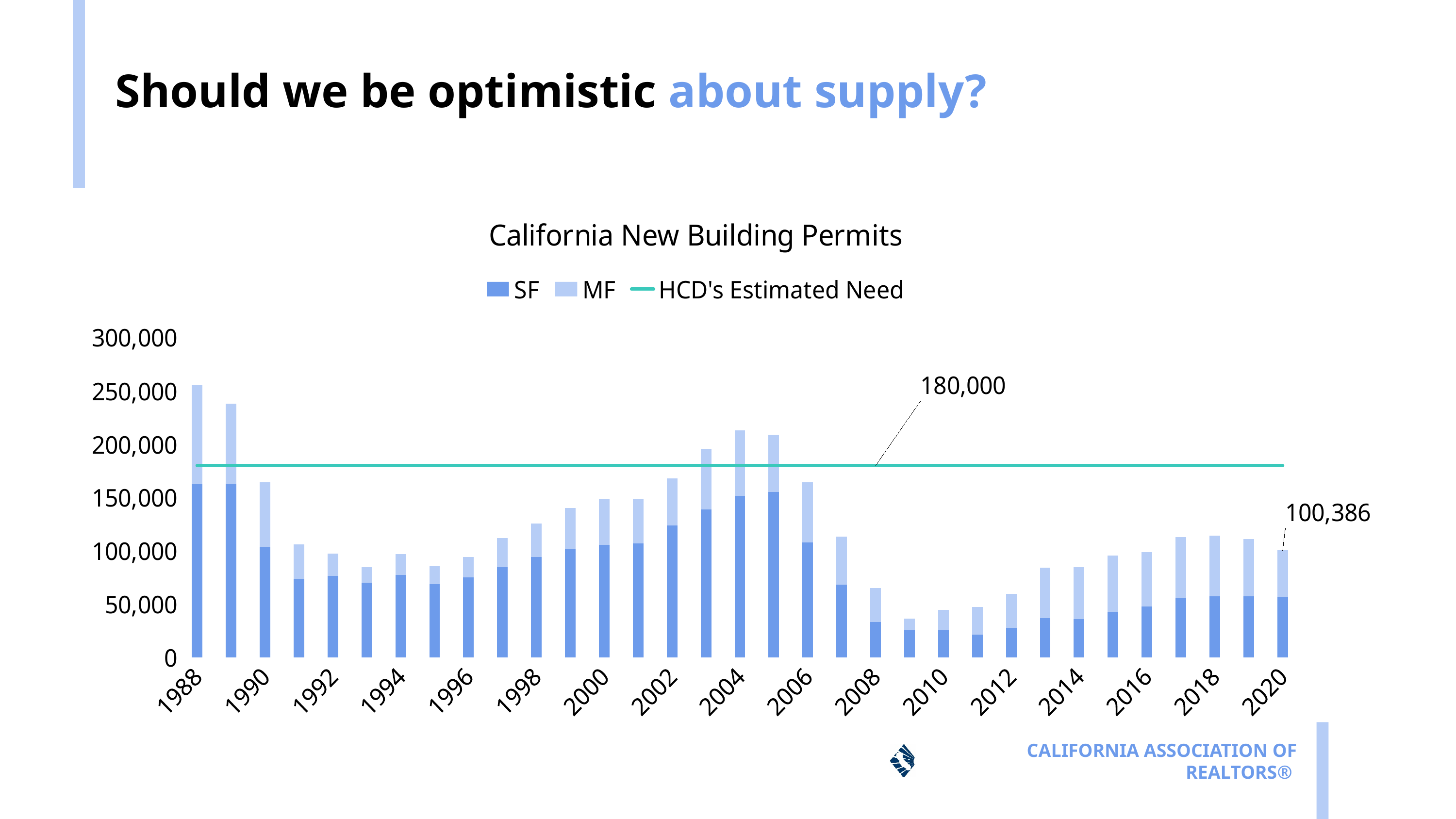
Which year has the highest total bar? 1988 What is the title of the chart? California New Building Permits Is the total bar for 2009 greater or less than 50,000? less How many series does the legend list? 3 What value is labelled for HCD's Estimated Need? 180,000 Do the total bars rise or fall from 2005 to 2009? fall Is the total bar for 2004 greater or less than 200,000? greater Which year has the lowest total bar? 2009 Which legend entry is drawn as a line rather than bars? HCD's Estimated Need Which year has a larger total bar, 2005 or 2006? 2005 What kind of chart is shown on the slide? combination bar and line chart What is the labelled total of new building permits for 2020? 100,386